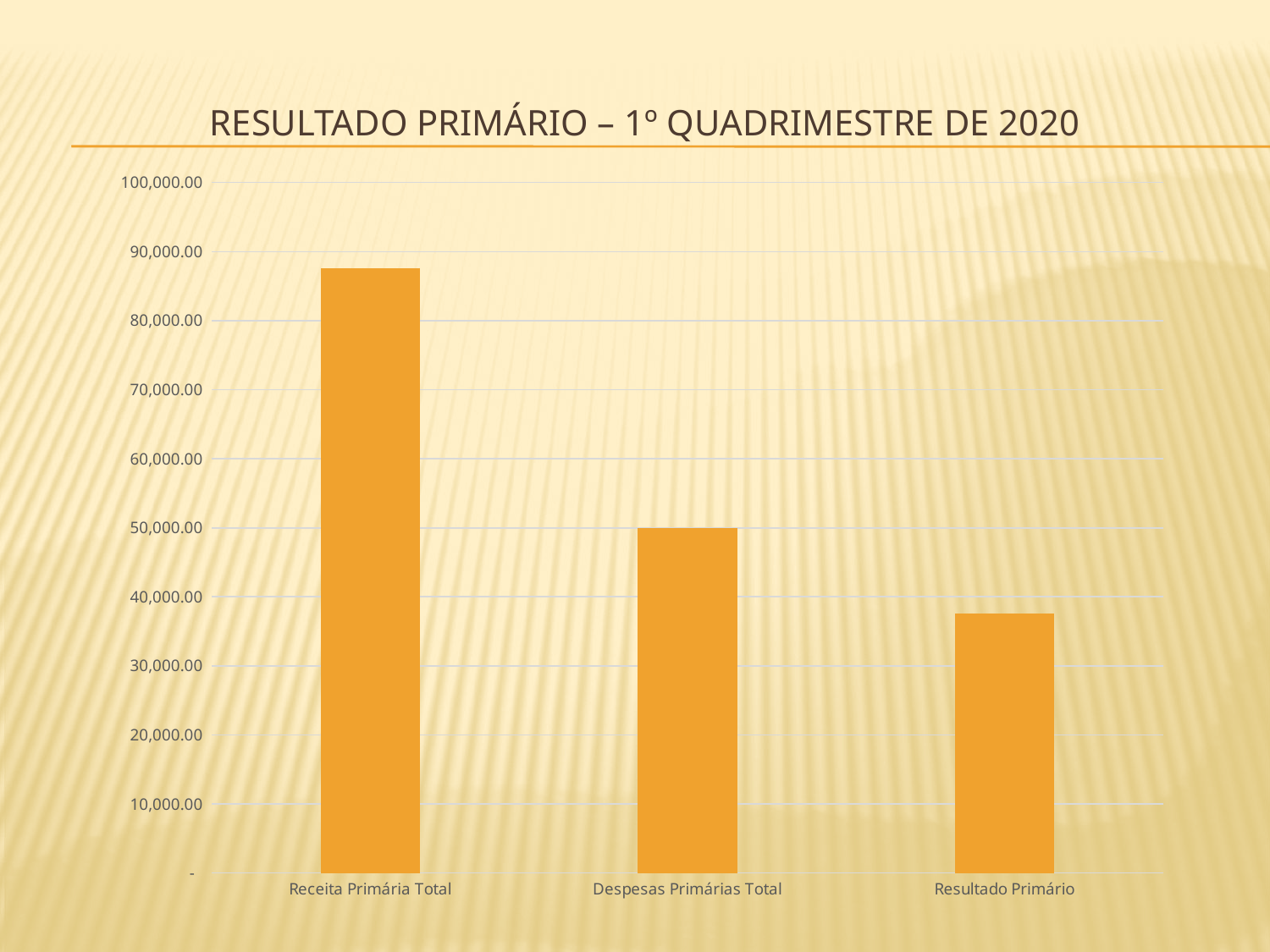
How many categories are plotted in the chart? 3 Which is larger, Receita Primária Total or Despesas Primárias Total? Receita Primária Total Which category has the lowest value? Resultado Primário What kind of chart is shown on the slide? bar chart Which category has the highest value? Receita Primária Total Which is larger, Despesas Primárias Total or Resultado Primário? Despesas Primárias Total What is the title of the chart? RESULTADO PRIMÁRIO – 1º QUADRIMESTRE DE 2020 Is the value for Receita Primária Total greater or less than 90,000.00? less Is the value for Resultado Primário greater or less than 40,000.00? less Is the value for Receita Primária Total greater or less than 80,000.00? greater Do the bar values rise or fall from left to right across the categories? fall